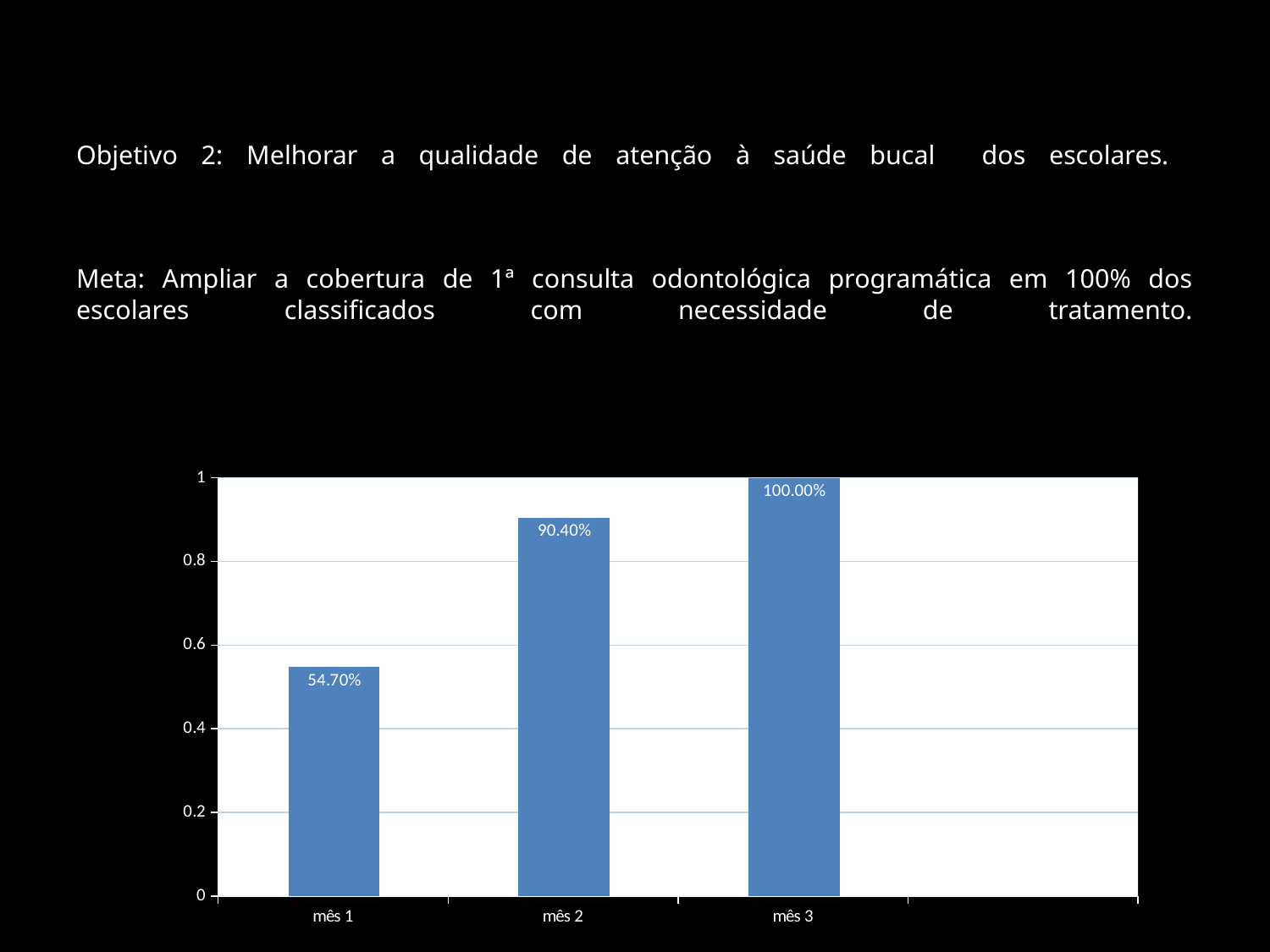
What is the difference between the values for mês 2 and mês 1? 35.70% Do the values rise or fall from mês 1 to mês 3? rise What kind of chart is shown on the slide? bar chart Which month has the highest value? mês 3 What is the value for mês 2? 90.40% Is the value for mês 1 greater or less than 0.6? less What is the value for mês 1? 54.70% How many categories are shown on the x axis? 3 What is the difference between the values for mês 3 and mês 2? 9.60% Which month has the lowest value? mês 1 Which is larger, the value for mês 1 or the value for mês 2? mês 2 What is the value for mês 3? 100.00%